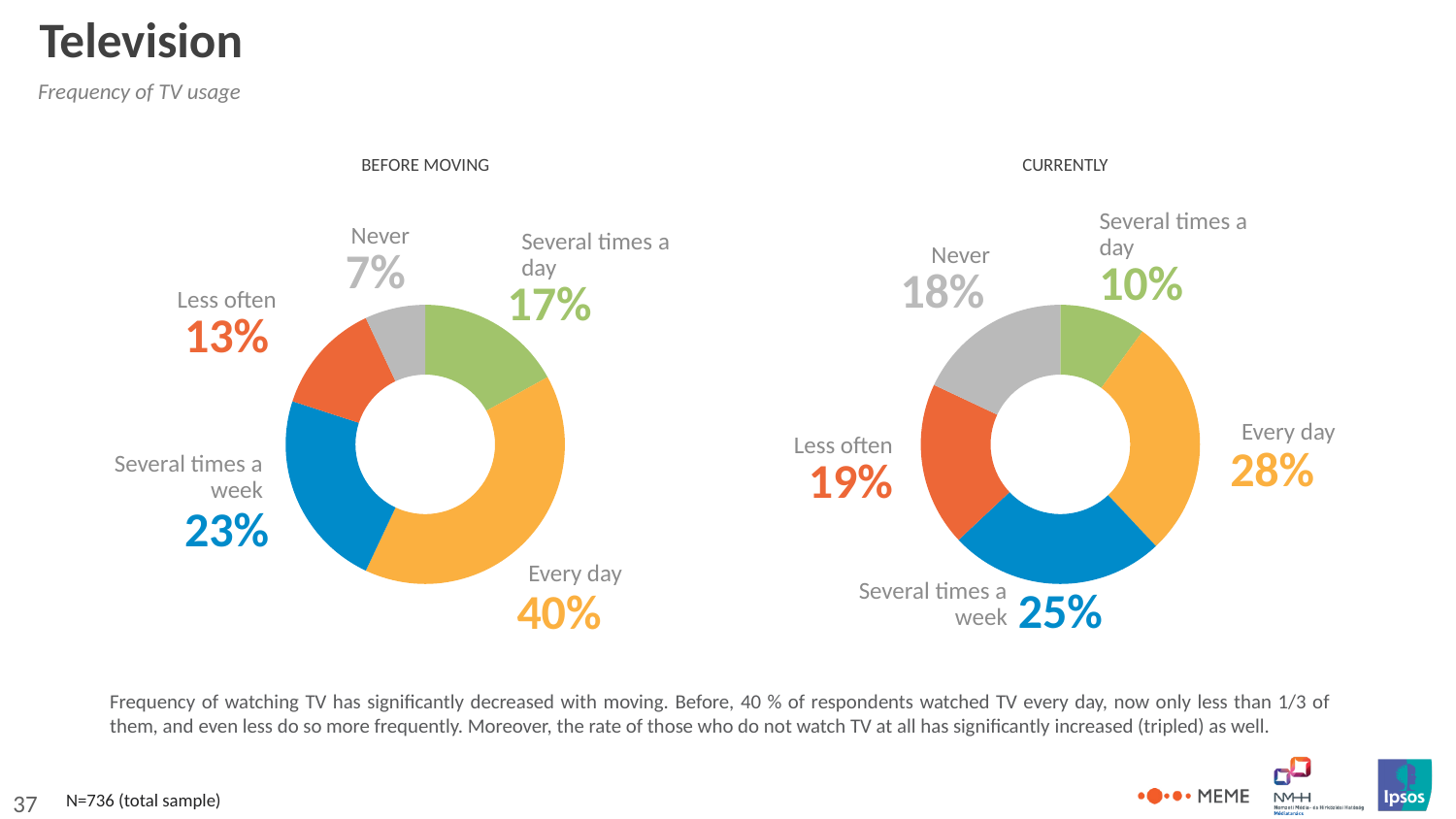
What is the title of the chart on the right side of the slide? CURRENTLY In the BEFORE MOVING chart, what is the combined share of Every day and Several times a day? 57% What type of chart is used for the CURRENTLY data? Doughnut chart In the CURRENTLY chart, what is the value for Several times a week? 25% In the CURRENTLY chart, what percentage of respondents never watch TV? 18% What is the difference between the Every day share in the BEFORE MOVING chart and the Every day share in the CURRENTLY chart? 12% In the CURRENTLY chart, which is larger: Less often or Several times a day? Less often In the BEFORE MOVING chart, what percentage of respondents watched TV every day? 40% How many categories does the BEFORE MOVING chart show? 5 In the BEFORE MOVING chart, which category has the largest share? Every day In the CURRENTLY chart, which category has the smallest share? Several times a day In the BEFORE MOVING chart, which category has the smallest share? Never